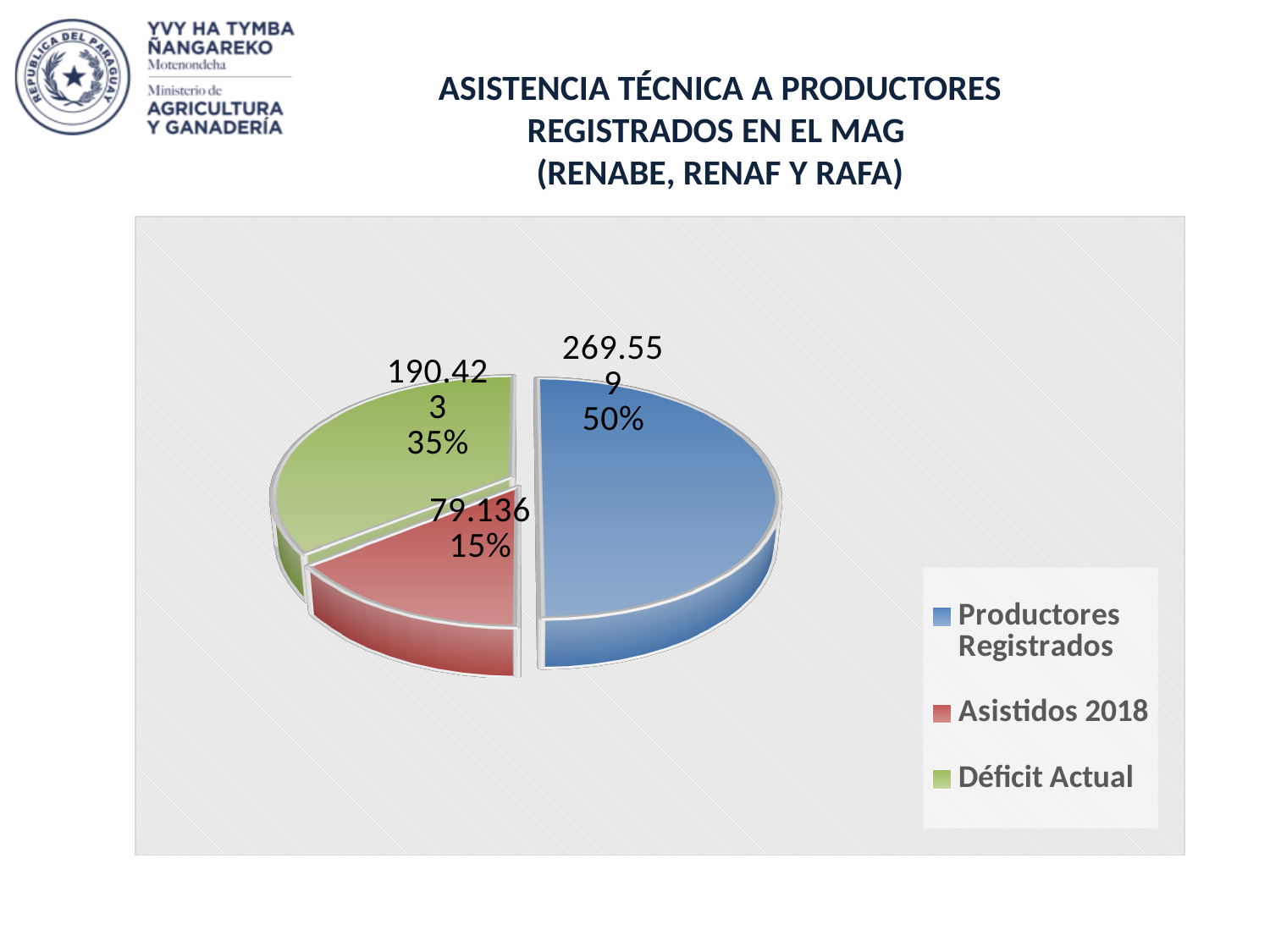
Which is larger, Déficit Actual or Asistidos 2018? Déficit Actual What is the value shown for Asistidos 2018? 79.136 Which slice of the pie is the smallest? Asistidos 2018 What percentage share of the pie does Productores Registrados have? 50% What kind of chart is shown on the slide? pie chart What is the value shown for Productores Registrados? 269.559 What percentage share of the pie does Asistidos 2018 have? 15% What colour is the Déficit Actual slice? green What is the value shown for Déficit Actual? 190.423 What percentage share of the pie does Déficit Actual have? 35% Which slice of the pie is the largest? Productores Registrados How many slices does the pie chart have? 3